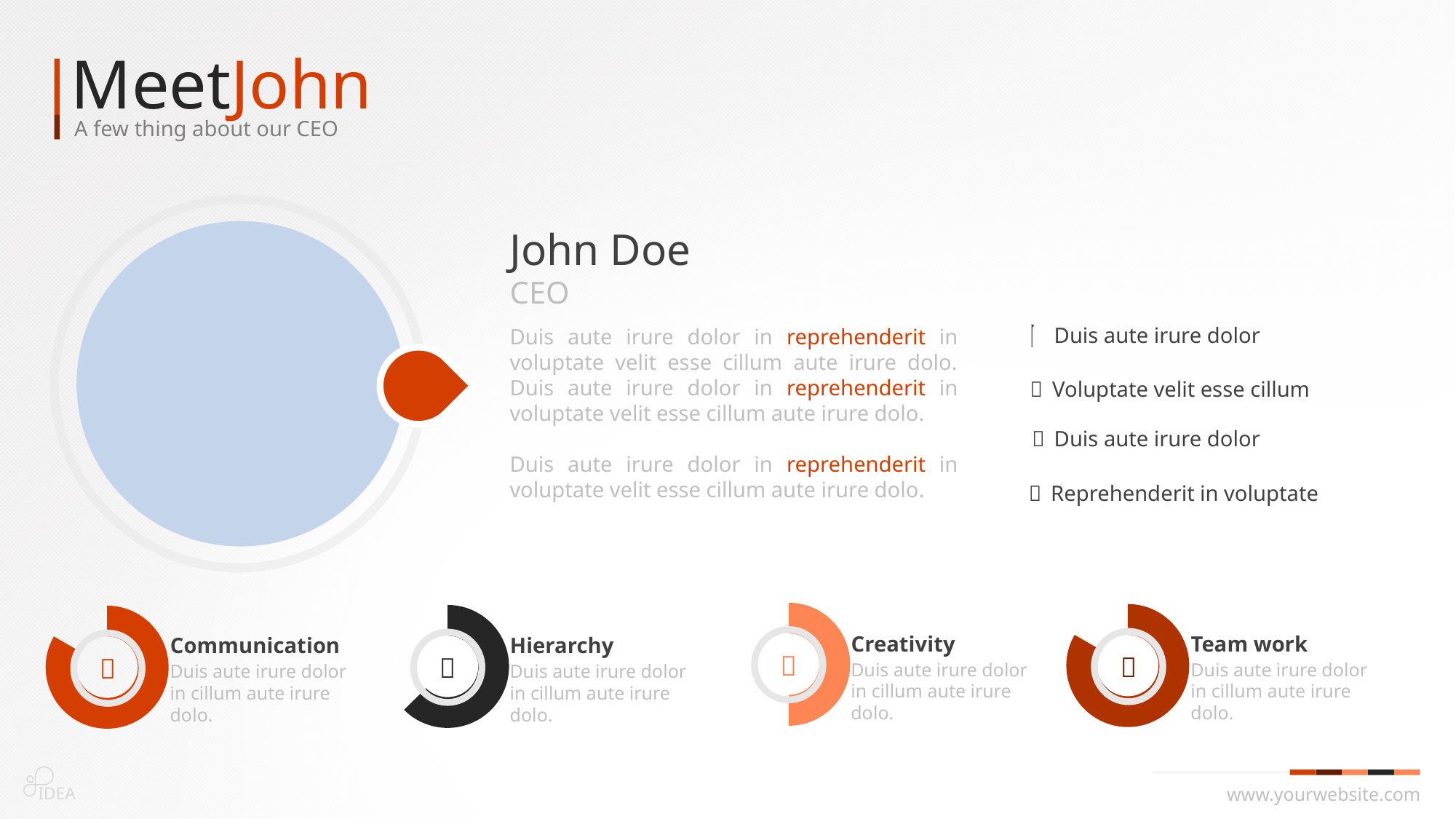
What colour is the filled portion of the Creativity ring chart? Light orange What kind of chart is used for the four indicators at the bottom of the slide (Communication, Hierarchy, Creativity, Team work)? Doughnut (ring) chart Comparing the Communication ring chart and the Hierarchy ring chart, which one has the larger filled portion? Communication Which indicator is shown by the first ring chart on the left at the bottom of the slide? Communication Which indicator is shown by the ring chart furthest to the right at the bottom of the slide? Team work What colour is the filled portion of the Hierarchy ring chart? Dark grey/black Comparing the Team work ring chart and the Creativity ring chart, which one has the larger filled portion? Team work How many small ring charts are shown along the bottom of the slide? 4